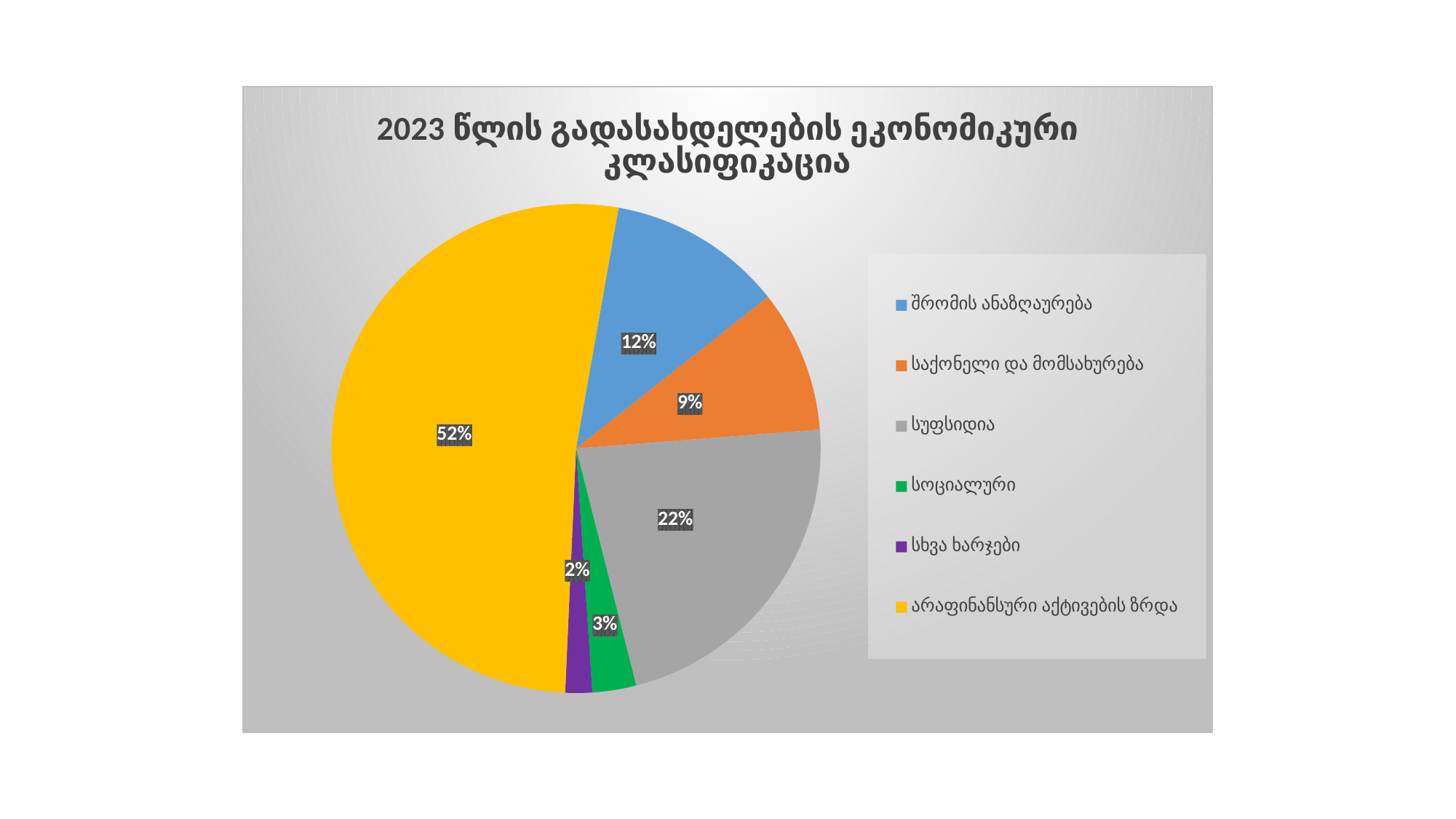
What is the share for არაფინანსური აქტივების ზრდა? 52% What is the share for სოციალური? 3% What type of chart is shown on the slide? pie chart What is the share for საქონელი და მომსახურება? 9% What is the difference in percentage points between სუფსიდია and შრომის ანაზღაურება? 10 How many categories does the legend list? 6 Which category has the smallest slice of the pie? სხვა ხარჯები What is the share for შრომის ანაზღაურება? 12% What is the share for სხვა ხარჯები? 2% What is the share for სუფსიდია? 22% Which category has the largest slice of the pie? არაფინანსური აქტივების ზრდა Which is larger, the share for შრომის ანაზღაურება or the share for საქონელი და მომსახურება? შრომის ანაზღაურება